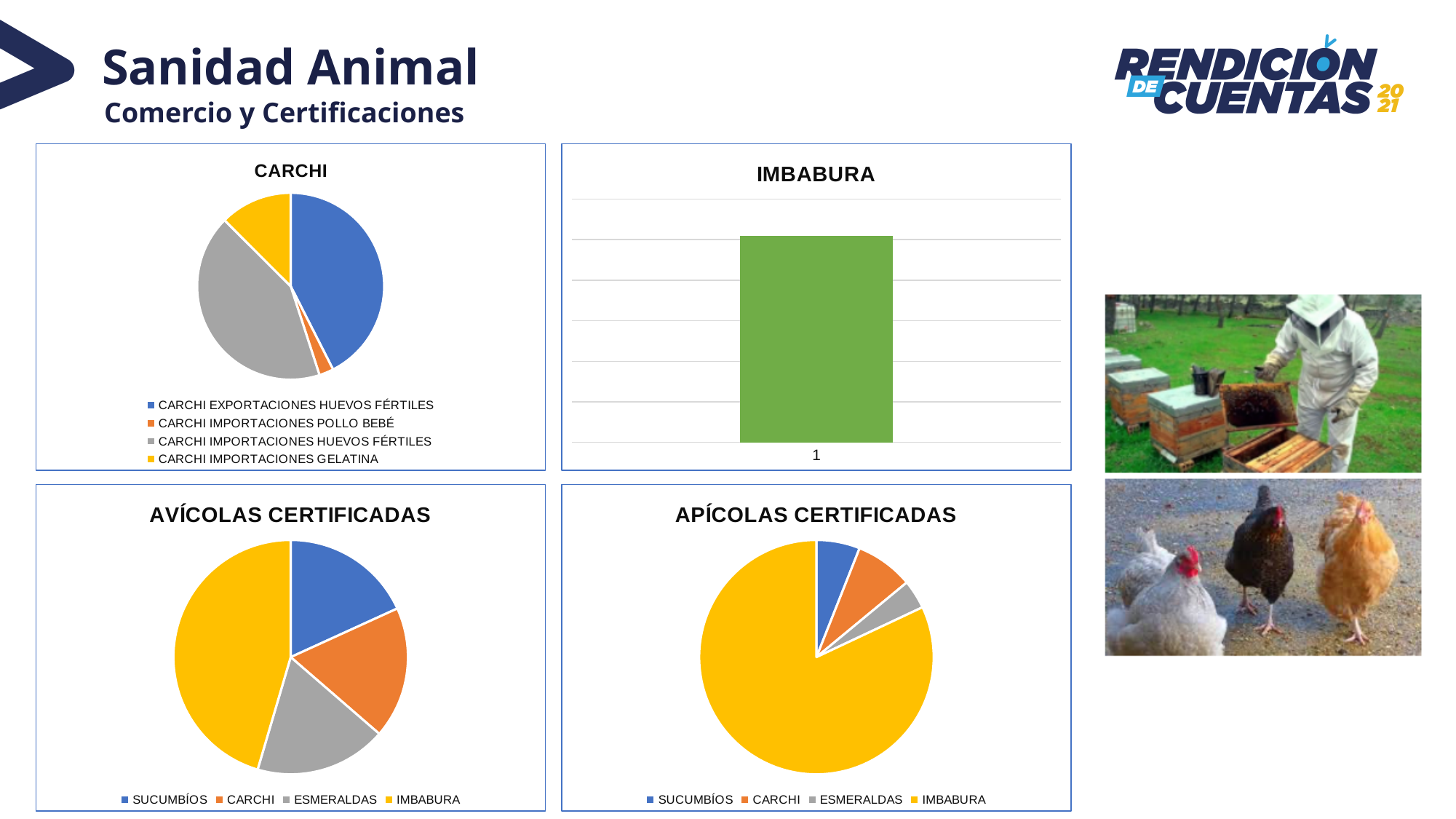
What kind of chart is the CARCHI chart? pie chart In the APÍCOLAS CERTIFICADAS pie chart, which slice is larger: CARCHI or ESMERALDAS? CARCHI In the AVÍCOLAS CERTIFICADAS pie chart, which province has the largest slice? IMBABURA How many slices does the CARCHI pie chart have? 4 In the APÍCOLAS CERTIFICADAS pie chart, which province has the largest slice? IMBABURA What is the category label under the bar in the IMBABURA chart? 1 In the CARCHI pie chart, which slice is larger: CARCHI IMPORTACIONES GELATINA or CARCHI IMPORTACIONES POLLO BEBÉ? CARCHI IMPORTACIONES GELATINA In the AVÍCOLAS CERTIFICADAS pie chart, which slice is larger: IMBABURA or SUCUMBÍOS? IMBABURA What kind of chart is the IMBABURA chart? bar chart How many bars does the IMBABURA bar chart show? 1 In the CARCHI pie chart, which category has the smallest slice? CARCHI IMPORTACIONES POLLO BEBÉ How many provinces does the legend of the AVÍCOLAS CERTIFICADAS chart list? 4